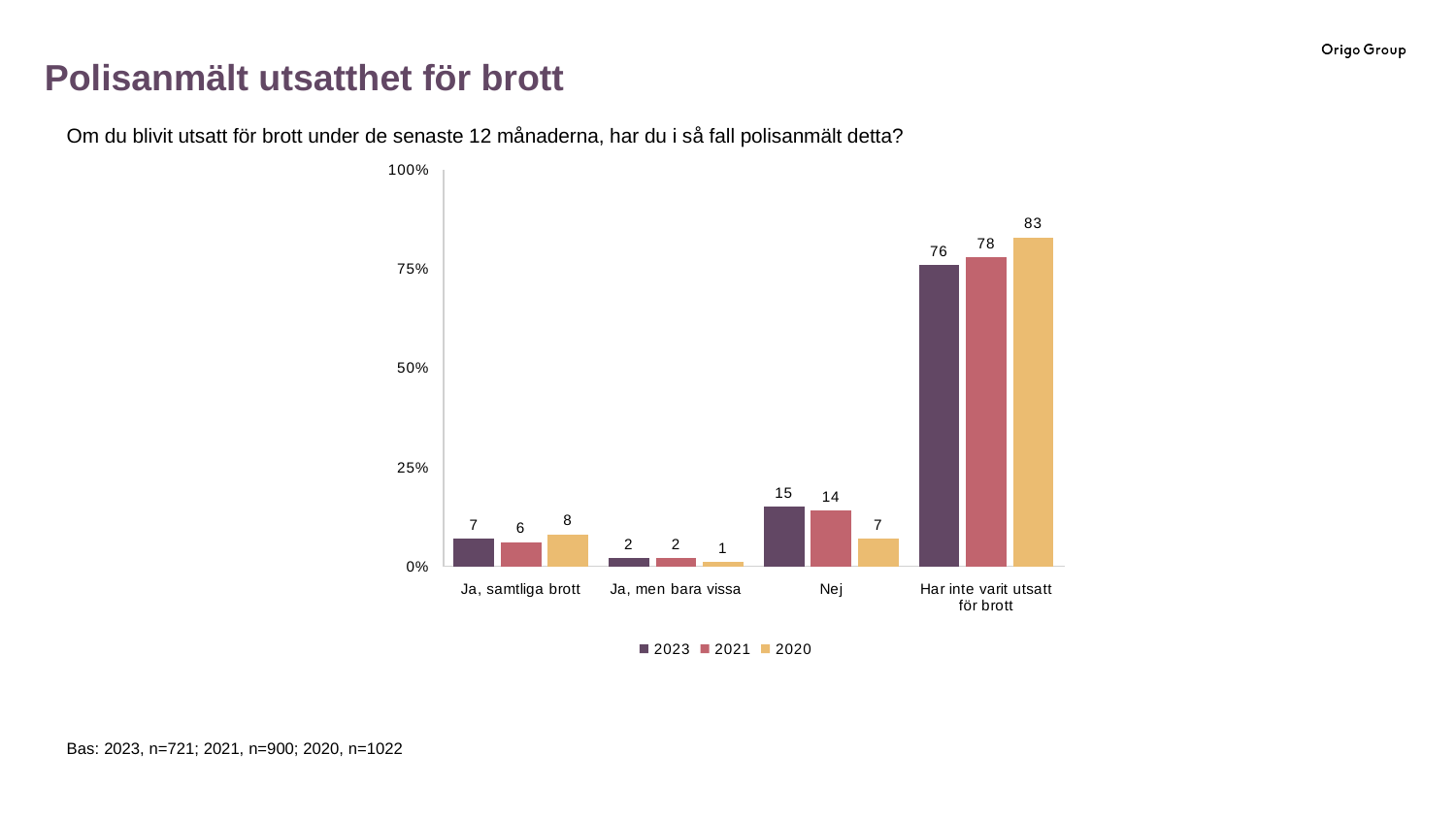
How many series does the legend list? 3 Which category has the lowest value for 2020? Ja, men bara vissa What kind of chart is shown on the slide? Bar chart Is the value for 2021 in the "Har inte varit utsatt för brott" category greater or less than 75%? greater In the "Nej" category, which is larger: the value for 2023 or the value for 2020? 2023 What are the series names listed in the legend? 2023, 2021, 2020 What is the value for 2023 in the "Nej" category? 15 Which category has the highest value for 2023? Har inte varit utsatt för brott How many categories are shown on the x axis? 4 What is the value for 2020 in the "Har inte varit utsatt för brott" category? 83 What is the value for 2021 in the "Ja, samtliga brott" category? 6 What is the difference between the 2020 and 2023 values in the "Har inte varit utsatt för brott" category? 7